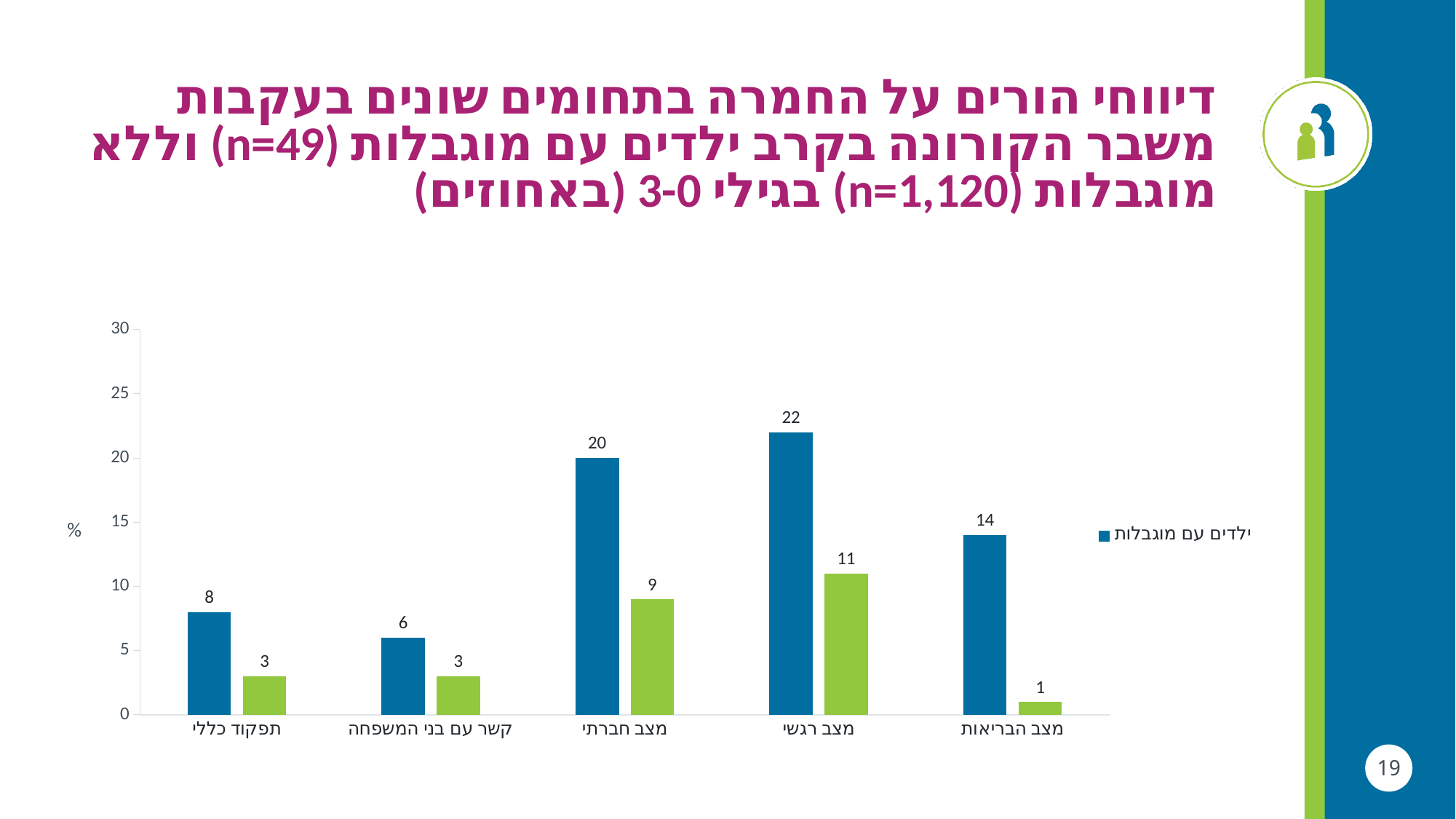
What kind of chart is shown on the slide? bar chart In which category is the blue bar (ילדים עם מוגבלות) highest? מצב רגשי What is the value of the green bar for מצב הבריאות? 1 What is the label on the y axis of the chart? % What is the value of the green bar for מצב חברתי? 9 What is the difference between the blue and green bars for מצב רגשי? 11 Which is larger: the blue bar for תפקוד כללי or the blue bar for קשר עם בני המשפחה? תפקוד כללי In which category is the green bar lowest? מצב הבריאות What is the value for ילדים עם מוגבלות in the מצב רגשי category? 22 What is the value of the blue bar for מצב הבריאות? 14 How many categories are shown on the x axis? 5 What is the difference between the blue bars for מצב חברתי and תפקוד כללי? 12